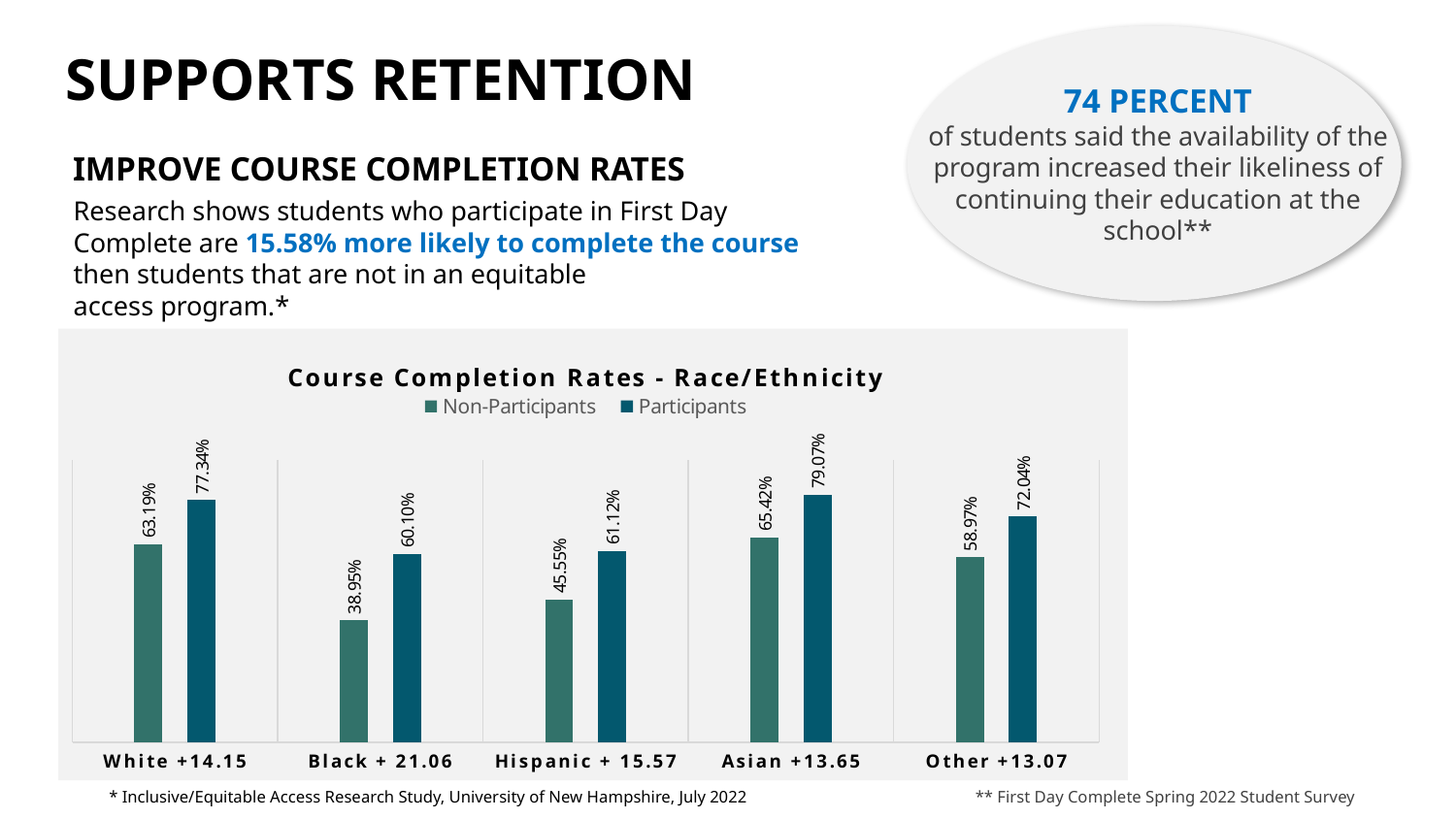
Which category has the highest Participants completion rate? Asian What is the course completion rate for Non-Participants in the Black category? 38.95% How many race/ethnicity categories are shown on the chart? 5 What is the course completion rate for Participants in the White category? 77.34% How many series does the chart legend list? 2 What is the title of the chart? Course Completion Rates - Race/Ethnicity What kind of chart is shown on the slide? bar chart What is the difference between the Participants and Non-Participants completion rates for the Asian category? 13.65% What is the course completion rate for Participants in the Hispanic category? 61.12% Which category has the lowest Non-Participants completion rate? Black Which is larger: the Non-Participants rate for Other or the Non-Participants rate for Hispanic? Other Which series is shown in the darker blue colour in the legend? Participants